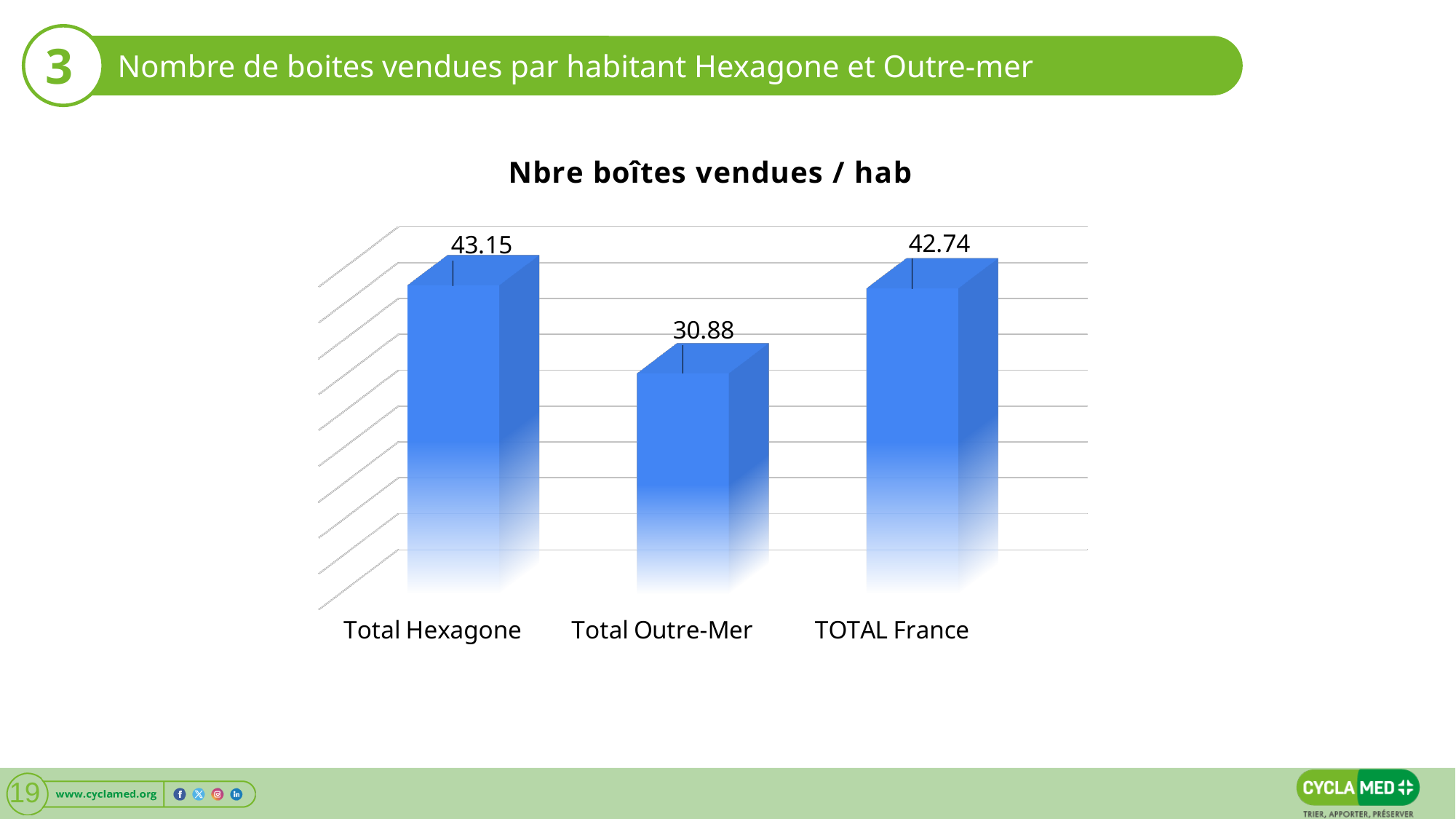
Which category has the highest value? Total Hexagone Which is larger, the value for Total Hexagone or the value for Total Outre-Mer? Total Hexagone What is the difference between the values for Total Hexagone and TOTAL France? 0.41 What is the value for TOTAL France? 42.74 What is the value for Total Hexagone? 43.15 How many categories are shown in the chart? 3 What kind of chart is shown on the slide? Bar chart What is the value for Total Outre-Mer? 30.88 What is the title of the chart? Nbre boîtes vendues / hab What is the difference between the values for Total Hexagone and Total Outre-Mer? 12.27 Which category has the lowest value? Total Outre-Mer What is the difference between the values for TOTAL France and Total Outre-Mer? 11.86